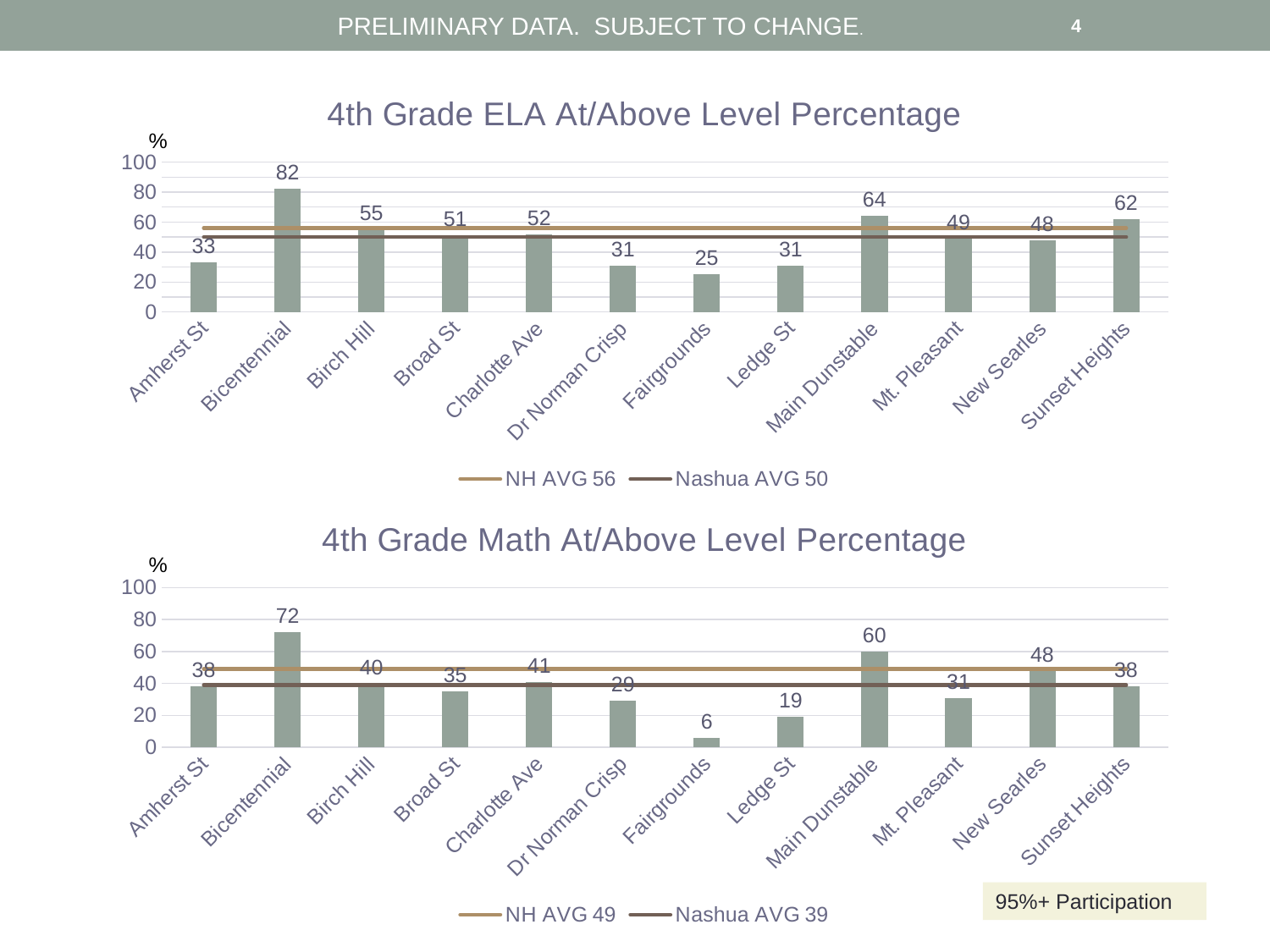
In the 4th Grade Math At/Above Level Percentage chart, which school has the highest value? Bicentennial How many schools are shown on the x axis of the 4th Grade Math At/Above Level Percentage chart? 12 In the 4th Grade Math At/Above Level Percentage chart, which is larger, Charlotte Ave or Broad St? Charlotte Ave In the 4th Grade ELA At/Above Level Percentage chart, what is the difference between Birch Hill and Ledge St? 24 In the 4th Grade ELA At/Above Level Percentage chart, is the value for Sunset Heights greater or less than 40? greater What kind of chart is the 4th Grade Math At/Above Level Percentage chart? Combination bar and line chart How many entries does the legend of the 4th Grade ELA At/Above Level Percentage chart list? 2 In the 4th Grade ELA At/Above Level Percentage chart, which school has the lowest value? Fairgrounds In the 4th Grade ELA At/Above Level Percentage chart, what is the difference between Main Dunstable and Amherst St? 31 In the 4th Grade Math At/Above Level Percentage chart, what is the value for Fairgrounds? 6 In the 4th Grade Math At/Above Level Percentage chart, what value does the legend give for the Nashua AVG line? 39 In the 4th Grade ELA At/Above Level Percentage chart, what is the value for Bicentennial? 82